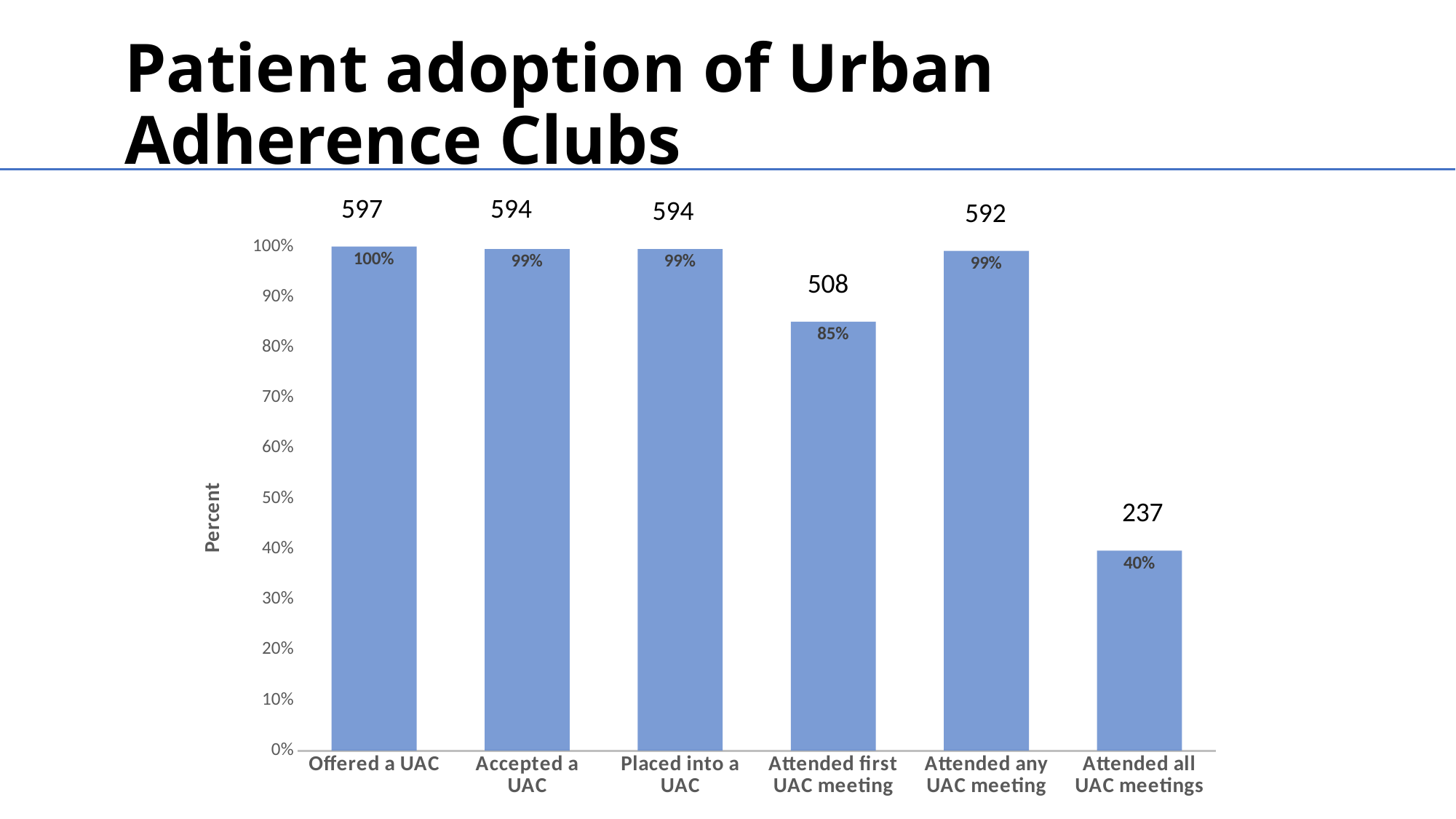
What is the label on the vertical axis? Percent What count is printed above the "Attended any UAC meeting" bar? 592 What is the difference between the counts for "Offered a UAC" and "Accepted a UAC"? 3 How many categories are shown on the x axis? 6 What percentage is shown for "Offered a UAC"? 100% What is the difference in percentage points between "Attended first UAC meeting" and "Attended all UAC meetings"? 45 What count is printed above the "Attended all UAC meetings" bar? 237 What kind of chart is shown on the slide? Bar chart Which category has the lowest percentage? Attended all UAC meetings Which is larger, the percentage for "Attended first UAC meeting" or for "Attended any UAC meeting"? Attended any UAC meeting Which category has the highest percentage? Offered a UAC What percentage is shown for "Attended first UAC meeting"? 85%